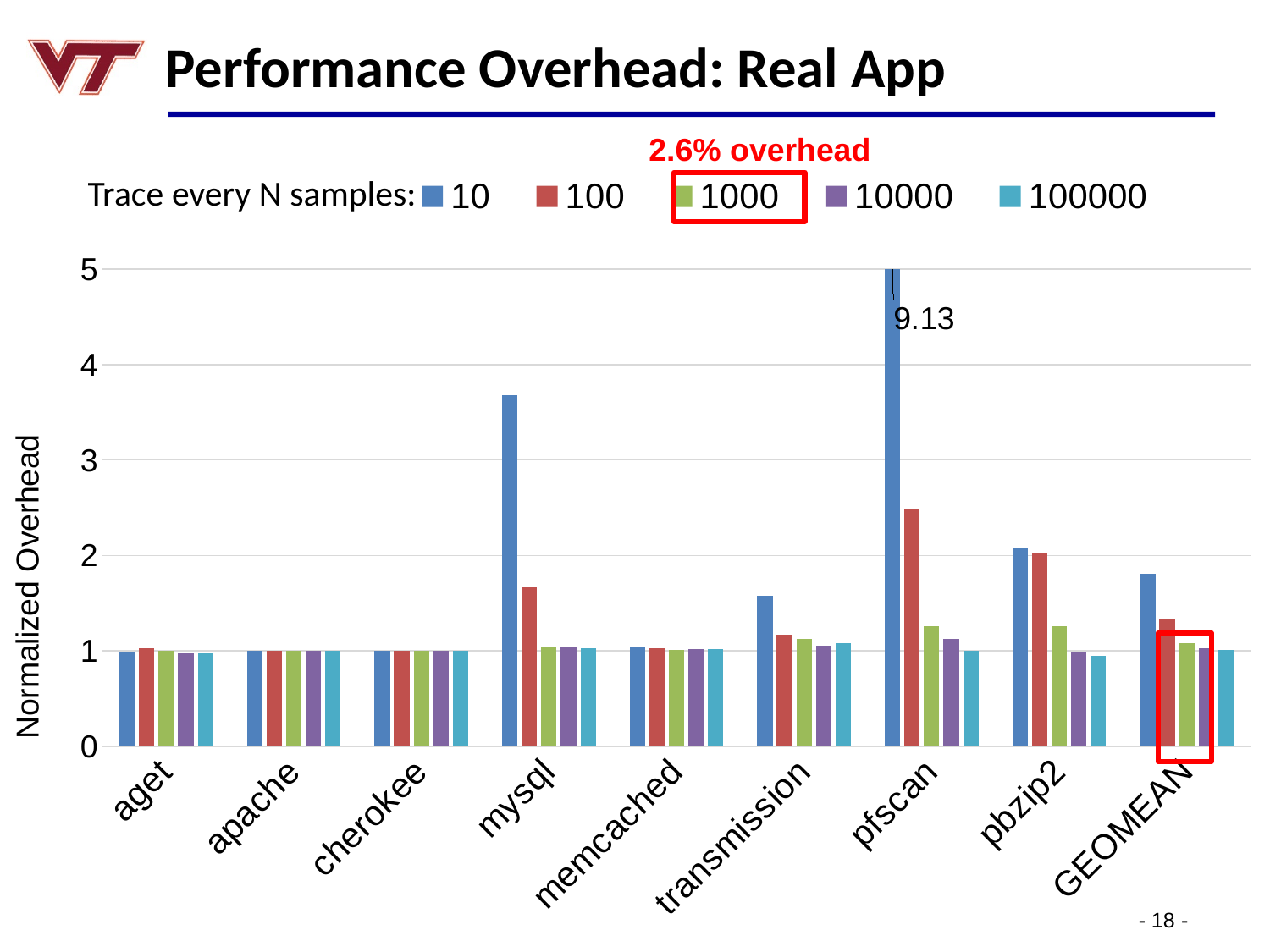
Is the normalized overhead for pbzip2 with tracing every 10 samples greater or less than 3? less For pfscan, do the normalized overhead values rise or fall as N (trace every N samples) increases from 10 to 100000? fall Which legend series is highlighted with a red box and annotated with '2.6% overhead'? 1000 Is the normalized overhead for pfscan with tracing every 100 samples greater or less than 2? greater What is the label of the y axis? Normalized Overhead What is the normalized overhead for pfscan when tracing every 10 samples? 9.13 What kind of chart is shown on the slide? bar chart How many applications (categories) are shown along the x axis of the chart? 9 Is the normalized overhead for mysql with tracing every 10 samples greater or less than 3? greater Which application has the highest normalized overhead for the 'trace every 10 samples' series? pfscan How many series does the legend list? 5 For mysql, which has the larger normalized overhead: tracing every 10 samples or tracing every 100 samples? tracing every 10 samples